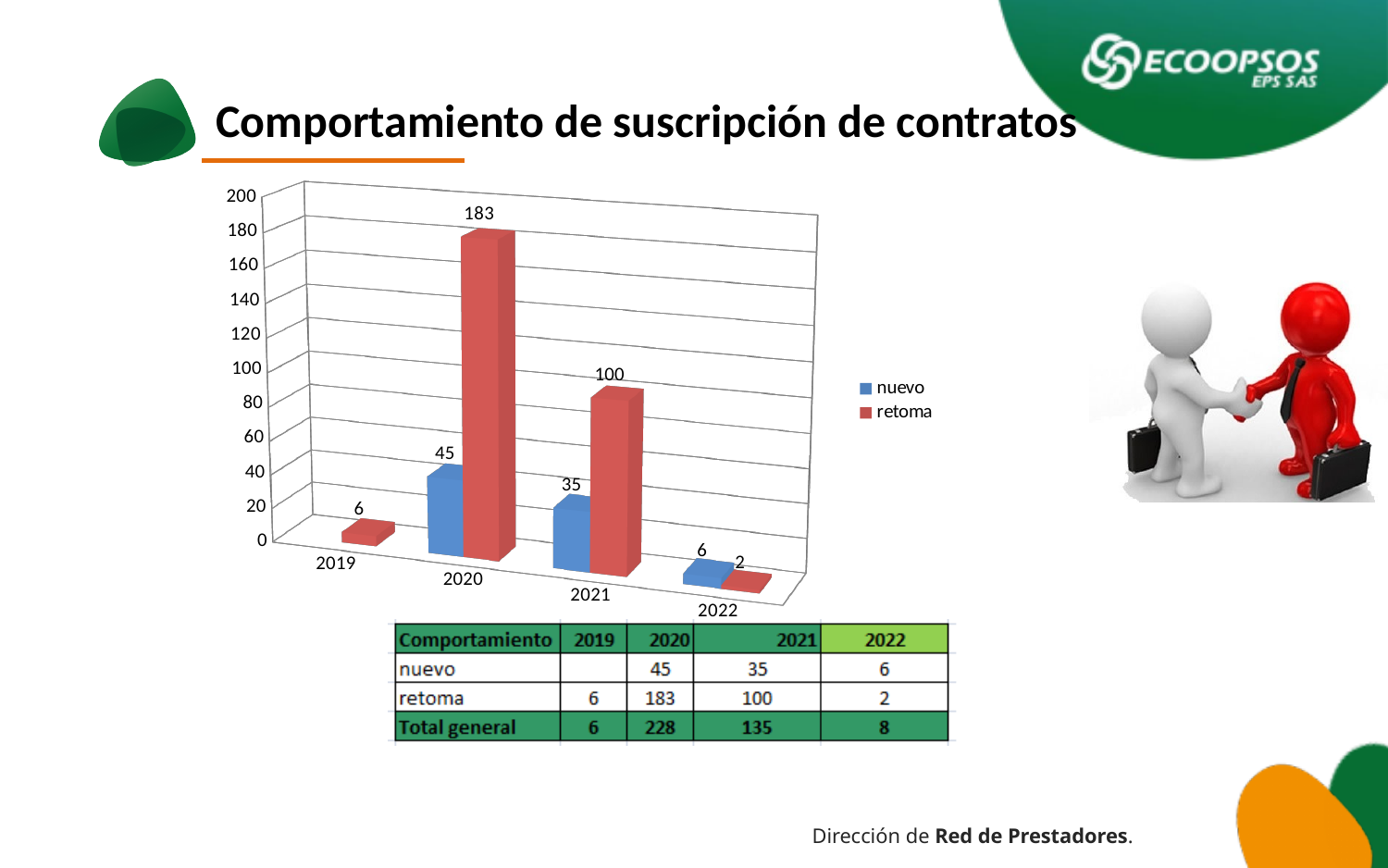
How many series does the legend list? 2 Which year has the highest retoma value? 2020 What is the value for nuevo in 2022? 6 What kind of chart is shown? bar chart Which is larger in 2020, nuevo or retoma? retoma What is the value for nuevo in 2021? 35 What is the title of the chart? Comportamiento de suscripción de contratos Which year has the lowest retoma value? 2022 What is the value for retoma in 2020? 183 How many years are shown on the x axis? 4 What is the difference between retoma and nuevo in 2021? 65 Does the retoma value rise or fall from 2020 to 2022? fall